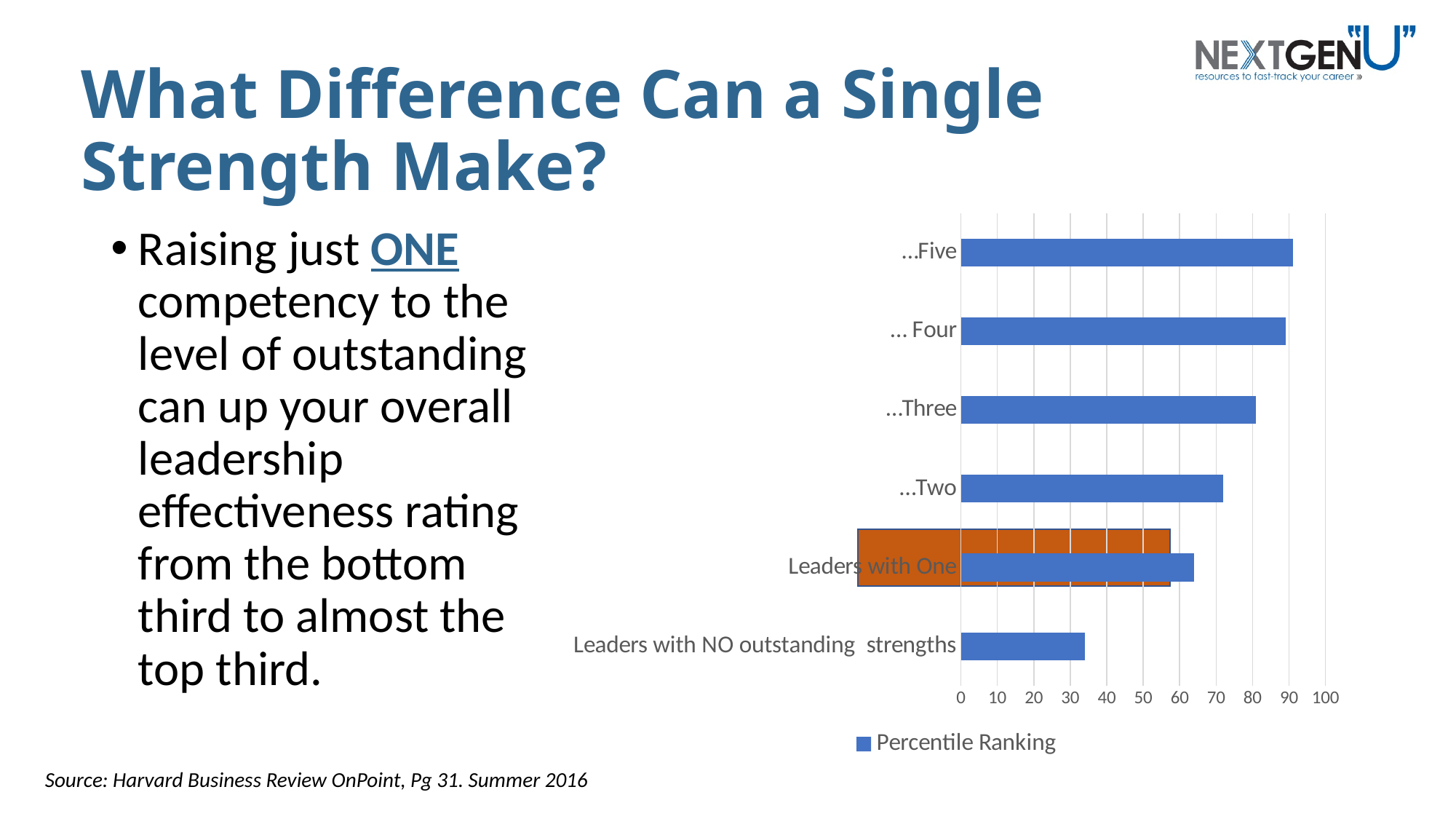
Which category has the highest percentile ranking? ...Five What is the name of the series shown in the chart legend? Percentile Ranking What kind of chart is shown on the slide? bar chart How many series does the chart legend list? 1 Is the value for Leaders with One greater or less than 60? greater Which category has the lowest percentile ranking? Leaders with NO outstanding strengths Is the value for ...Three greater or less than 90? less Is the value for ...Five greater or less than 80? greater How many categories are plotted in the chart? 6 Do the percentile rankings rise or fall as the number of outstanding strengths increases from none to five? rise Which has a higher percentile ranking, ...Three or ...Two? ...Three